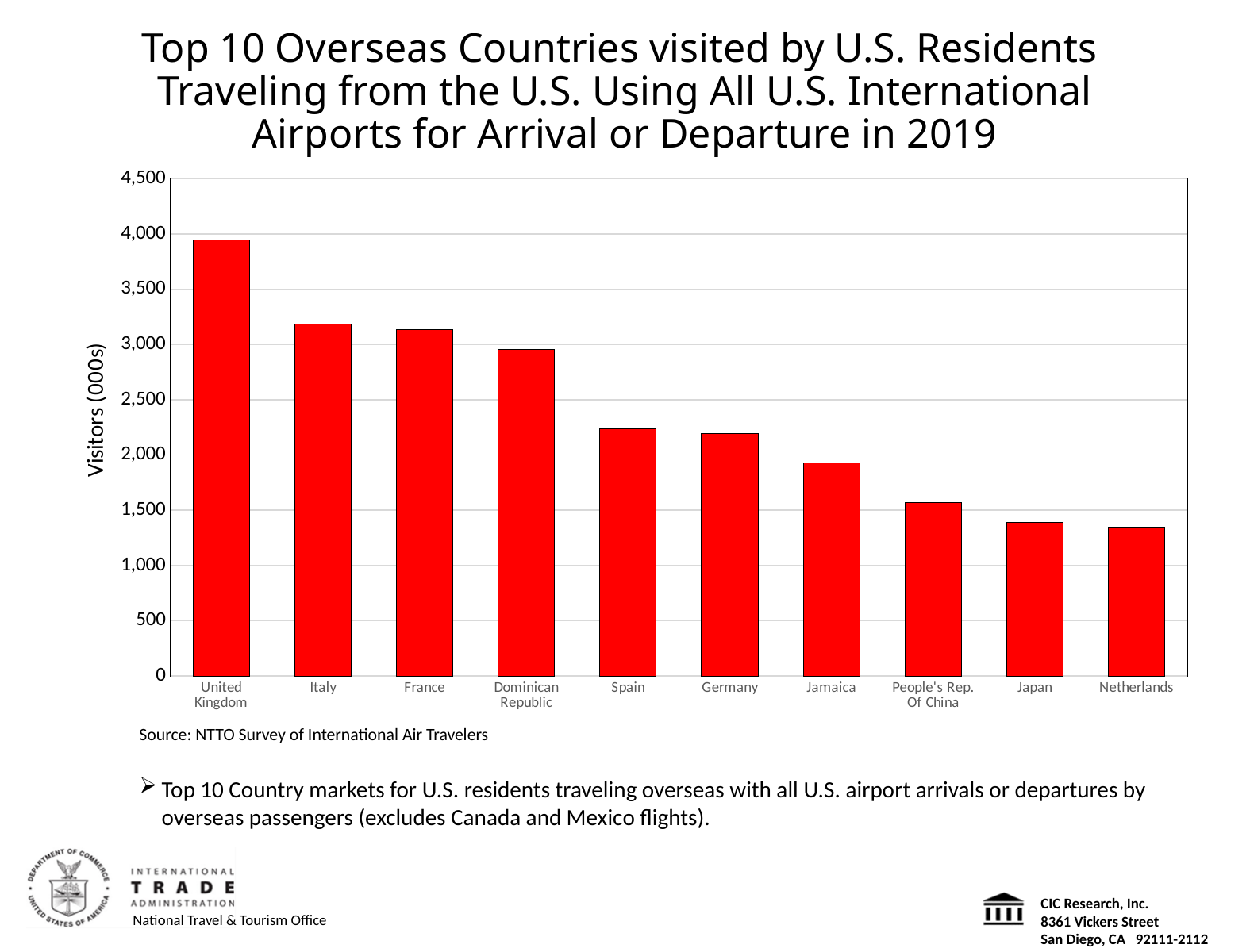
How many countries are shown on the chart? 10 What kind of chart is shown on the slide? bar chart Is the value for Jamaica greater or less than 2,000? less Do the values rise or fall from left to right across the countries? fall Is the value for Spain greater or less than 2,000? greater Which has more visitors, United Kingdom or Italy? United Kingdom Which country has the lowest number of visitors? Netherlands Which country has the highest number of visitors? United Kingdom Is the value for Japan greater or less than 1,500? less What is the label on the vertical axis of the chart? Visitors (000s)